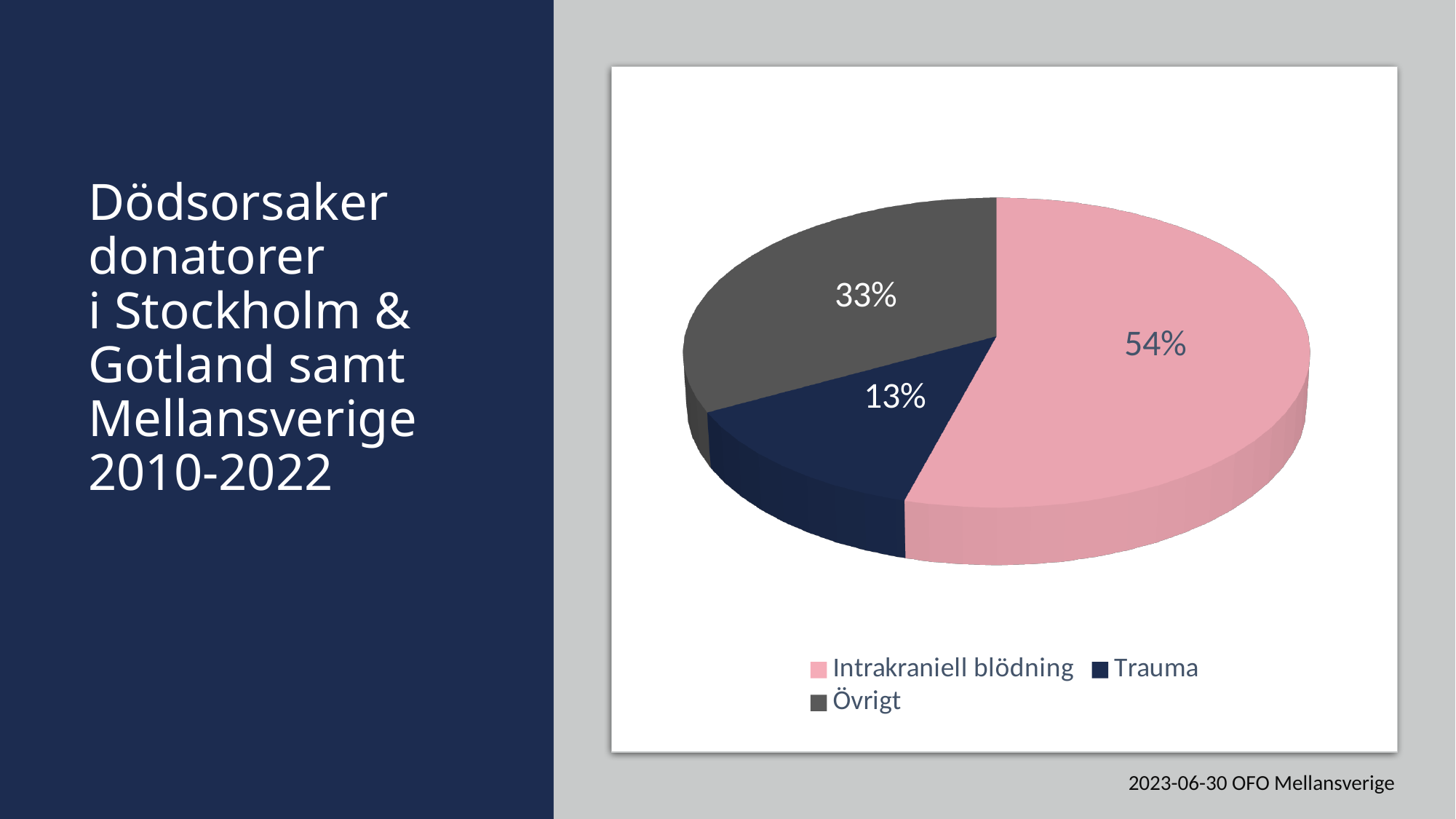
Which category has the largest slice of the pie? Intrakraniell blödning What share of the pie does Trauma account for? 13% Which category has the smallest slice of the pie? Trauma What share of the pie does Övrigt account for? 33% Which category is shown in dark navy blue in the pie chart? Trauma Which is larger, the share for Trauma or the share for Övrigt? Övrigt Which category is shown in pink in the pie chart? Intrakraniell blödning How many categories does the pie chart show? 3 What share of the pie does Intrakraniell blödning account for? 54% What kind of chart is shown on the slide? Pie chart What is the difference in percentage points between Intrakraniell blödning and Övrigt? 21 What is the difference in percentage points between Övrigt and Trauma? 20